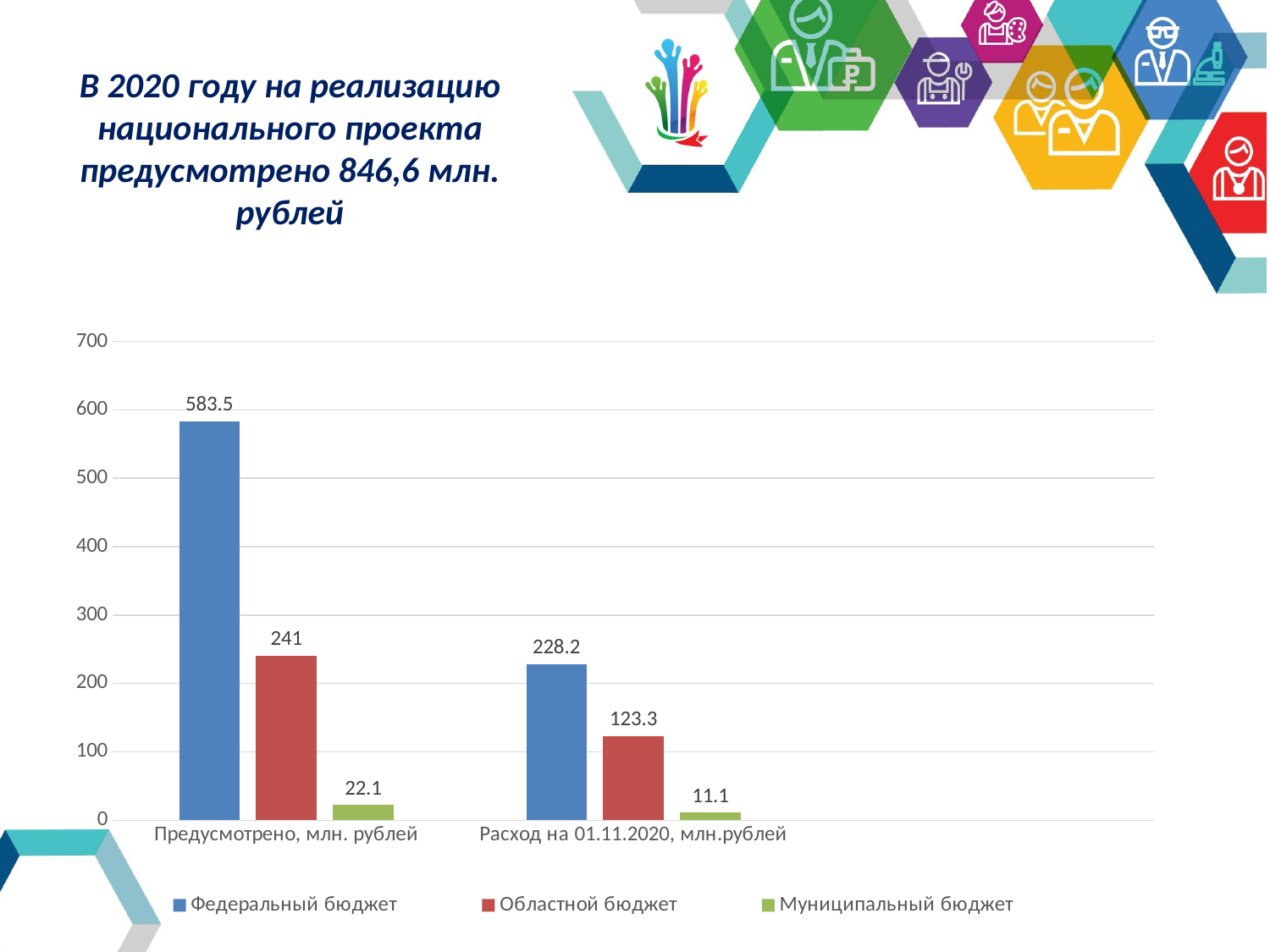
Which is larger: Областной бюджет for Предусмотрено, млн. рублей or Федеральный бюджет for Расход на 01.11.2020, млн.рублей? Областной бюджет for Предусмотрено, млн. рублей How many categories are shown on the x axis of the chart? 2 Which series has the highest value in the Расход на 01.11.2020, млн.рублей category? Федеральный бюджет What is the value for Федеральный бюджет in the Предусмотрено, млн. рублей category? 583.5 What colour are the bars for Муниципальный бюджет? green Is the value for Областной бюджет in the Предусмотрено, млн. рублей category greater or less than 200? greater What kind of chart is shown on the slide? bar chart Which series has the lowest value in the Предусмотрено, млн. рублей category? Муниципальный бюджет How many series does the legend list? 3 What is the difference between the Федеральный бюджет values for Предусмотрено, млн. рублей and Расход на 01.11.2020, млн.рублей? 355.3 What is the value for Муниципальный бюджет in the Предусмотрено, млн. рублей category? 22.1 What is the value for Областной бюджет in the Расход на 01.11.2020, млн.рублей category? 123.3